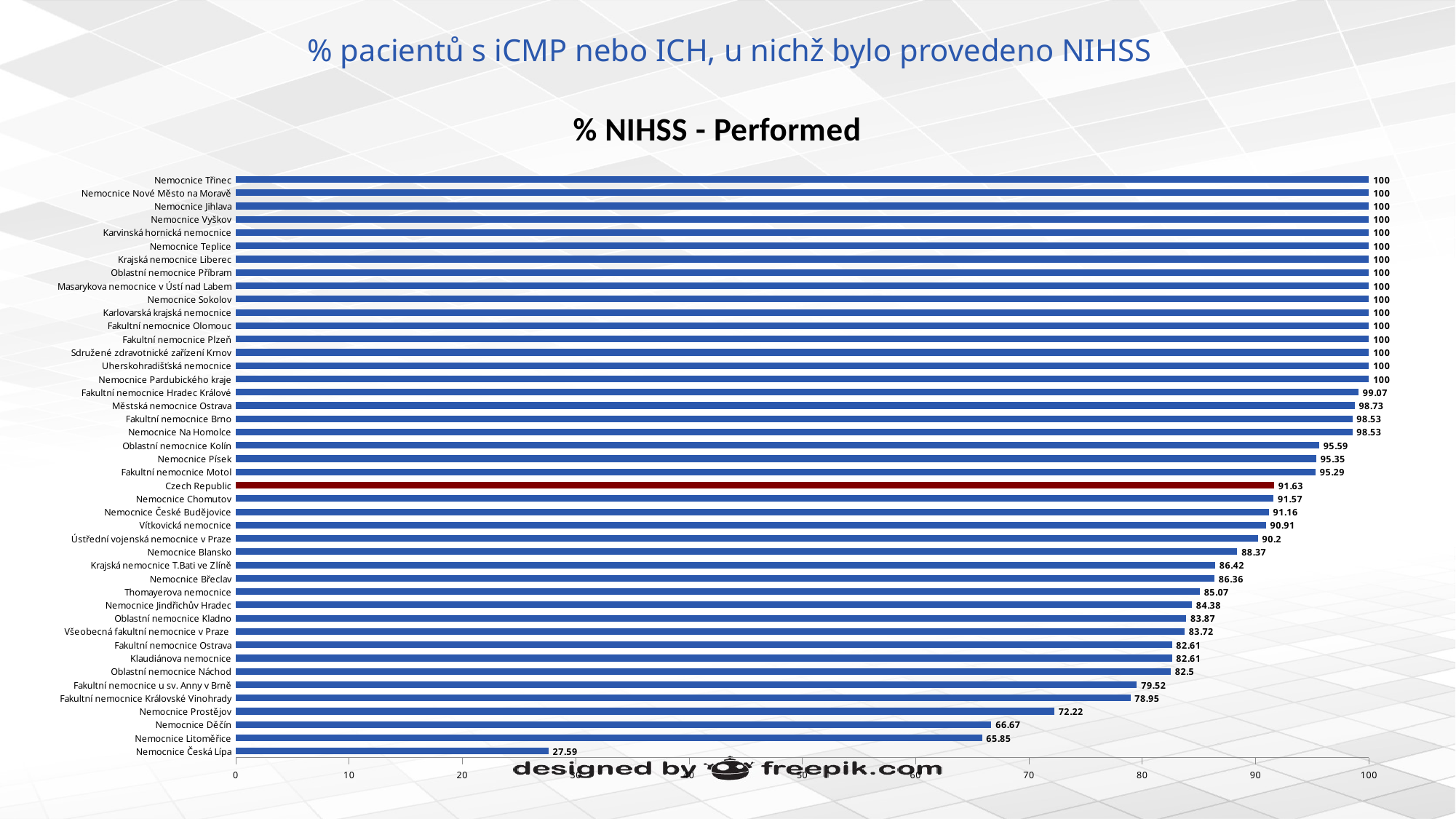
What is the value for Czech Republic? 91.63 What is the value for Nemocnice Česká Lípa? 27.59 What is the difference between the values for Nemocnice Děčín and Nemocnice Litoměřice? 0.82 What is the value for Nemocnice Prostějov? 72.22 Which bar is coloured differently from the others? Czech Republic Which is larger, the value for Nemocnice Blansko or the value for Nemocnice Břeclav? Nemocnice Blansko Which category has the lowest value? Nemocnice Česká Lípa What is the value for Fakultní nemocnice Hradec Králové? 99.07 What kind of chart is shown on the slide? bar chart Is the value for Fakultní nemocnice Královské Vinohrady greater or less than 80? less How many categories are shown in the chart? 44 What is the difference between the values for Czech Republic and Nemocnice Česká Lípa? 64.04